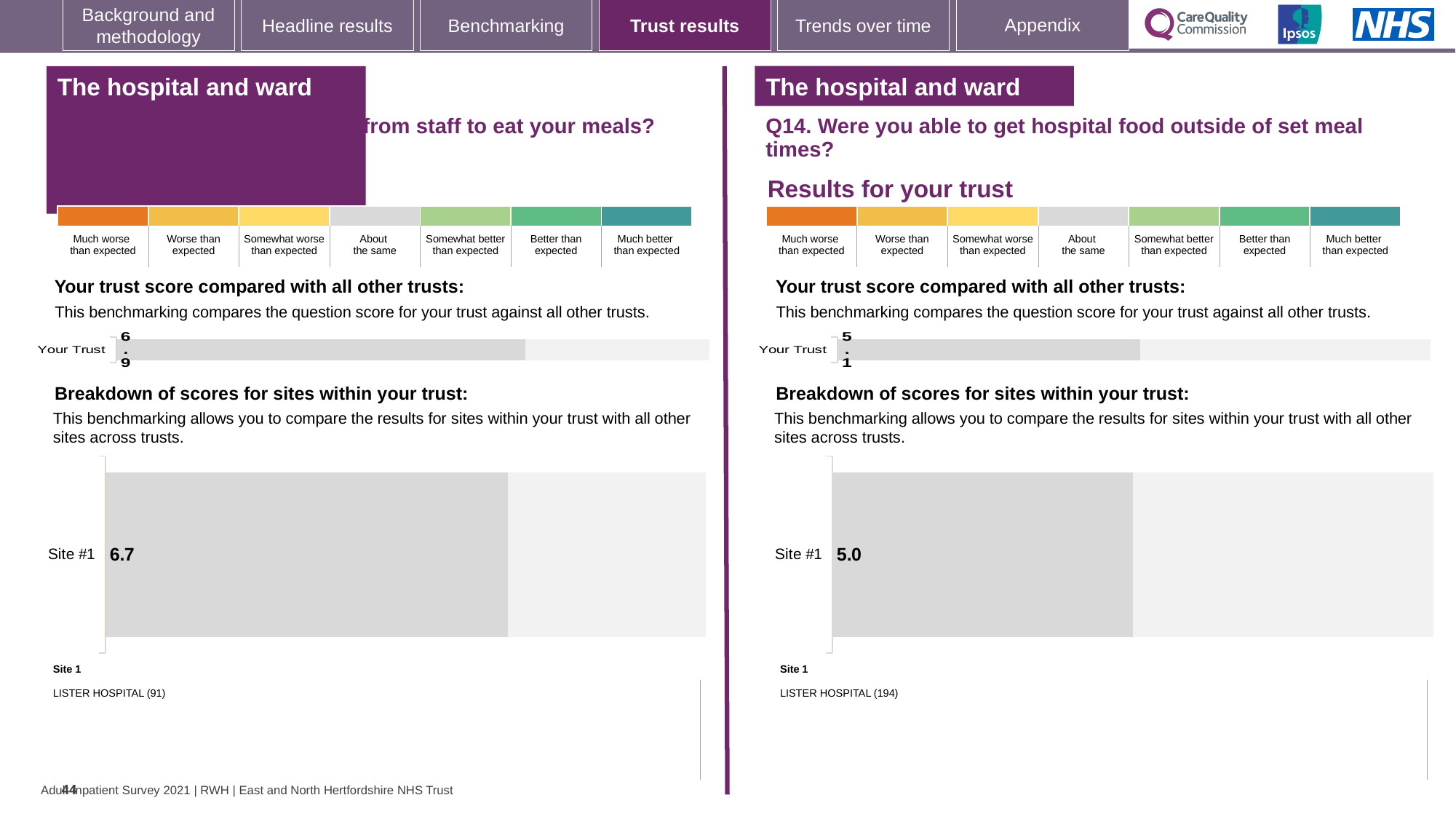
How many sites are shown in the 'Breakdown of scores for sites within your trust' chart on the right-hand side of the slide (Q14)? 1 On the right-hand side of the slide (Q14), what score is shown for Site #1 in the 'Breakdown of scores for sites within your trust' chart? 5.0 On the left-hand side of the slide, what is the difference between the Your Trust score and the Site #1 score? 0.2 Which is larger: the Site #1 score on the left-hand side of the slide or the Site #1 score on the right-hand side (Q14)? Left-hand side (6.7) What type of chart is used to show the Site #1 score on the right-hand side of the slide (Q14)? Bar chart Which is larger: the Your Trust score on the left-hand side of the slide or the Your Trust score on the right-hand side (Q14)? Left-hand side (6.9) On the left-hand side of the slide, what is the score shown for Your Trust in the 'Your trust score compared with all other trusts' chart? 6.9 On the left-hand side of the slide, what score is shown for Site #1 in the 'Breakdown of scores for sites within your trust' chart? 6.7 On the left-hand side of the slide, which hospital is listed as Site 1 below the site breakdown chart? LISTER HOSPITAL (91) On the right-hand side of the slide (Q14), which hospital is listed as Site 1 below the site breakdown chart? LISTER HOSPITAL (194) On the right-hand side of the slide (Q14, hospital food outside of set meal times), what is the score shown for Your Trust in the 'Your trust score compared with all other trusts' chart? 5.1 On the right-hand side of the slide (Q14), what is the difference between the Your Trust score and the Site #1 score? 0.1